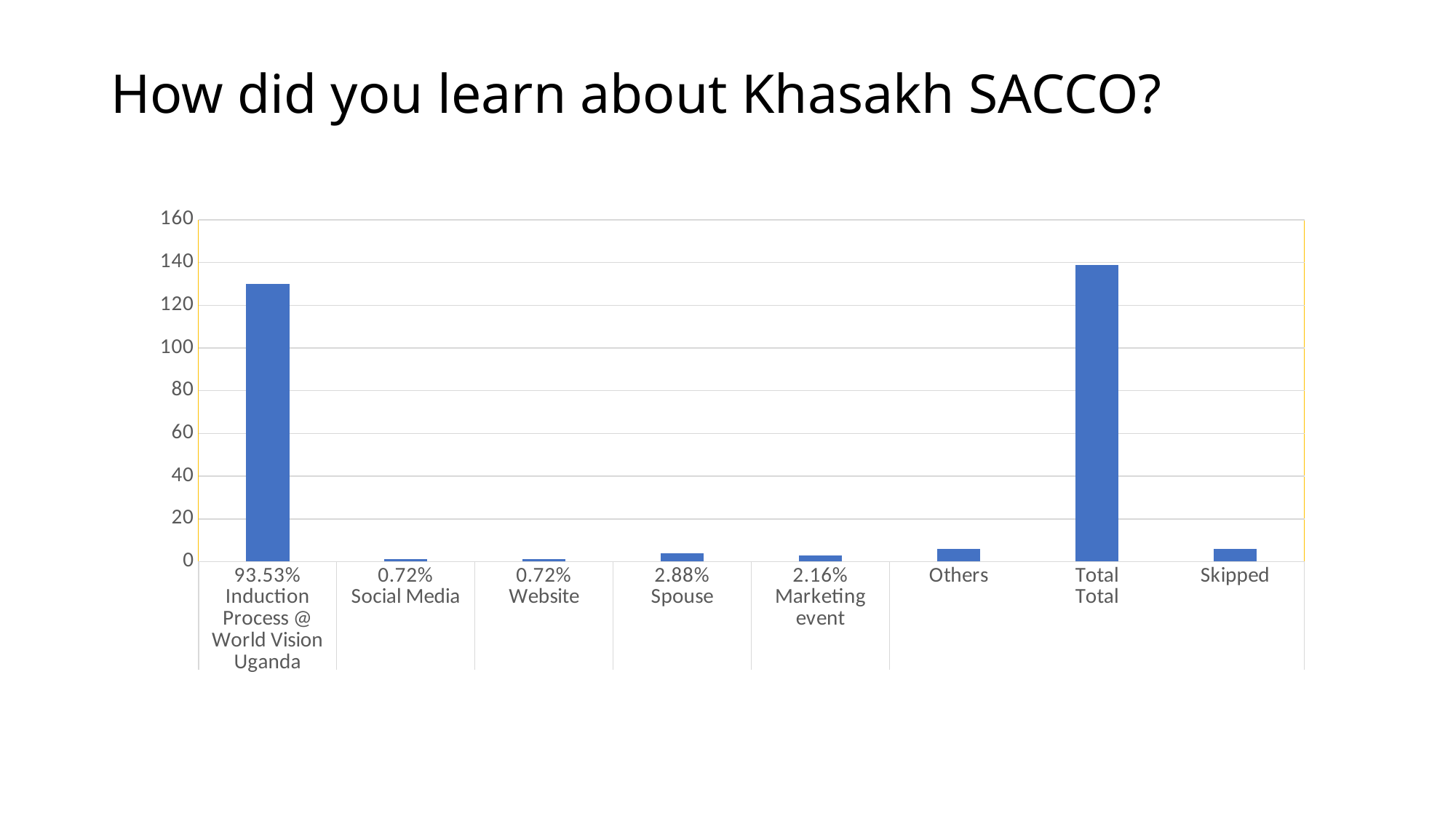
What is the title of the slide? How did you learn about Khasakh SACCO? Is the value for Induction Process @ World Vision Uganda greater or less than 120? greater Is the value for Total Total greater or less than 120? greater Is the value for Induction Process @ World Vision Uganda greater or less than 140? less Which is larger, the value for Total Total or the value for Induction Process @ World Vision Uganda? Total Total How many categories are shown on the x axis of the chart? 8 What percentage is printed in the axis label for Spouse? 2.88% What kind of chart is shown on the slide? bar chart Which category has the tallest bar in the chart? Total Total Which is larger, the value for Skipped or the value for Website? Skipped